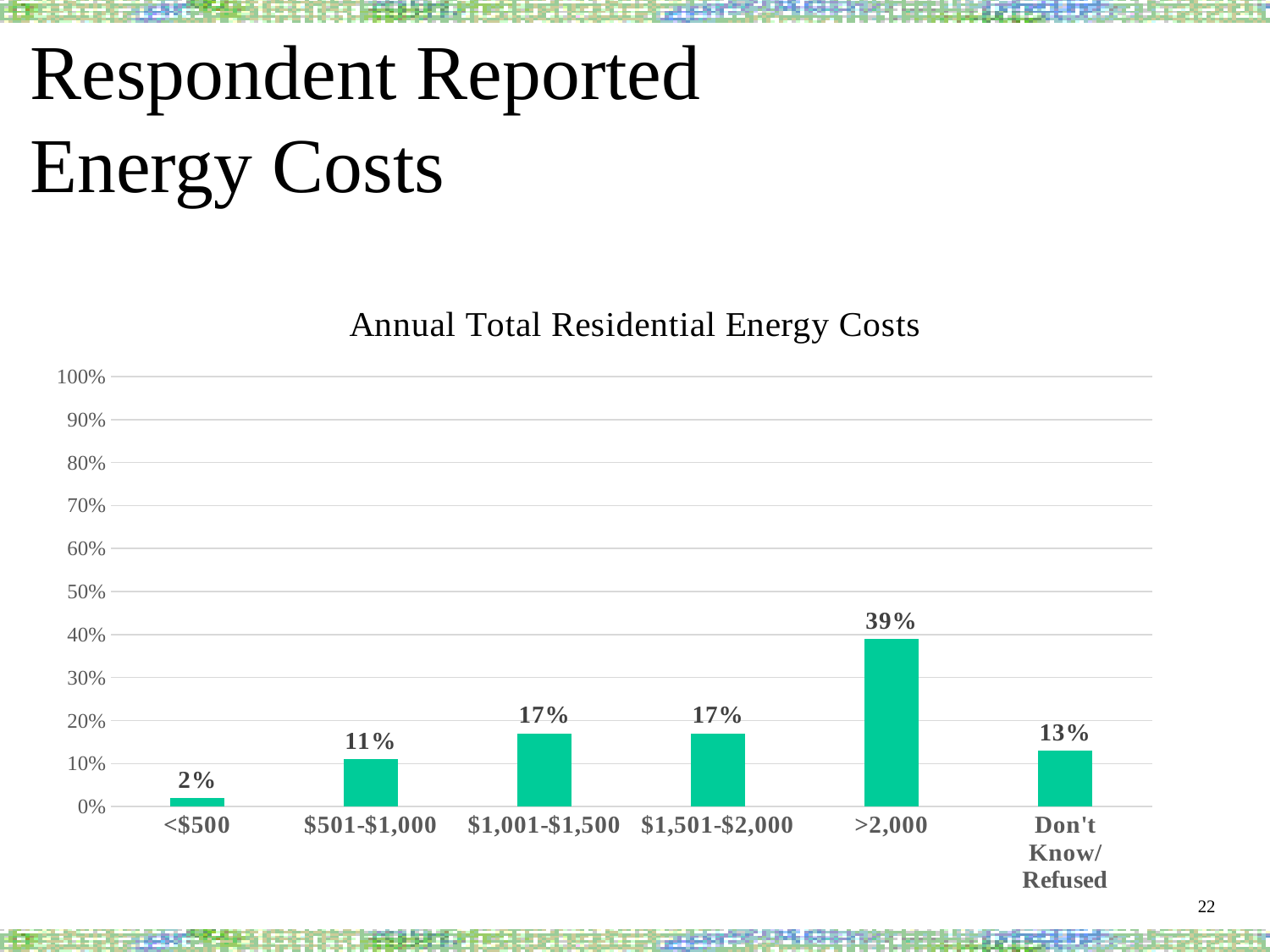
What is the value for the >2,000 category? 39% Which is larger, the value for $501-$1,000 or the value for Don't Know/Refused? Don't Know/Refused What is the difference between the values for >2,000 and Don't Know/Refused? 26% Which category has the lowest value? <$500 Is the value for >2,000 greater or less than 50%? less What is the value for the Don't Know/Refused category? 13% What kind of chart is shown on the slide? bar chart What is the value for the <$500 category? 2% What is the value for the $501-$1,000 category? 11% Which category has the highest value? >2,000 How many categories are shown on the x axis? 6 What is the title of the chart? Annual Total Residential Energy Costs